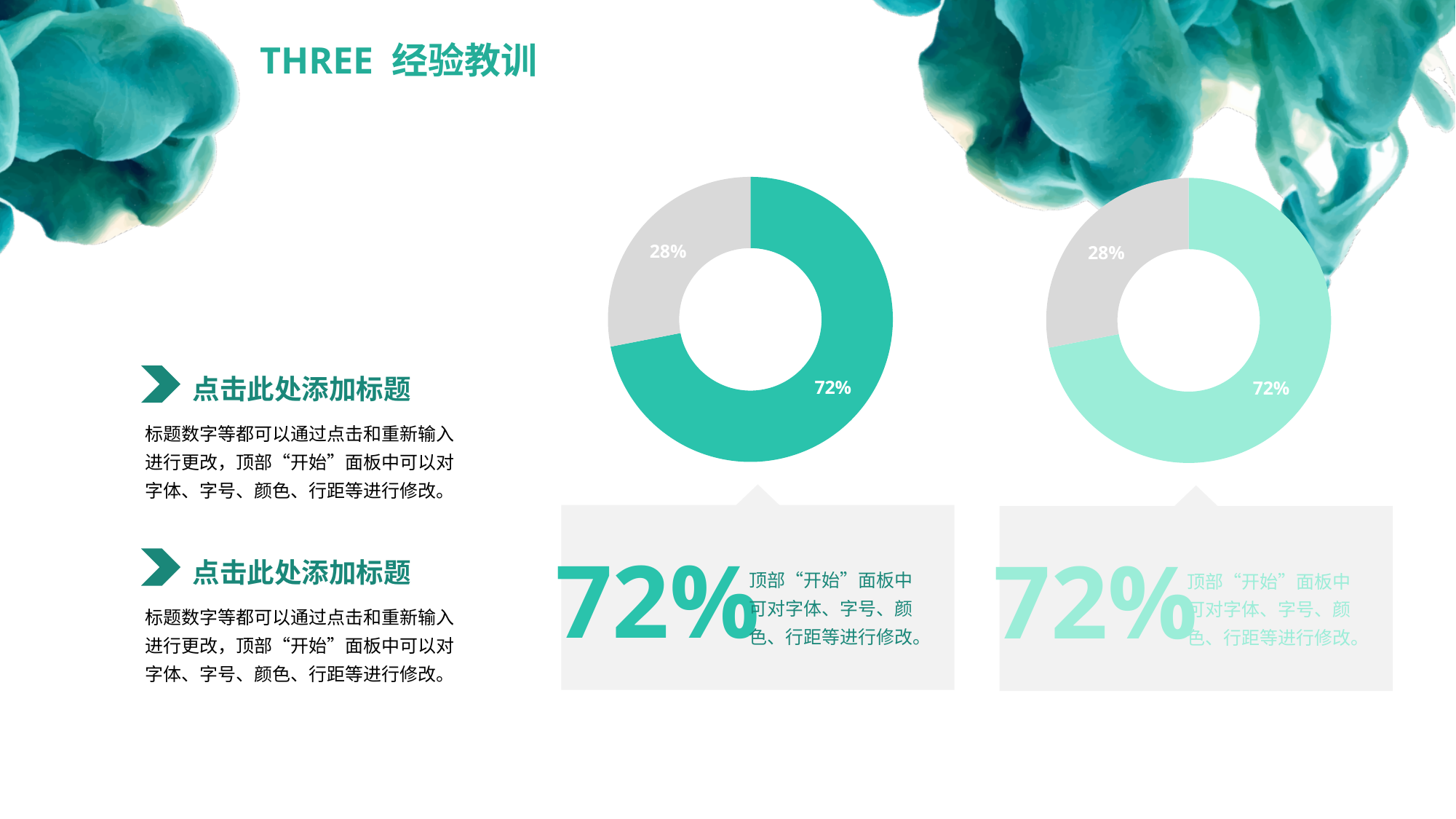
What kind of chart is the right chart on the slide? Doughnut chart What kind of chart is the left chart on the slide? Doughnut chart How many slices does the right doughnut chart have? 2 In the right doughnut chart, what value is shown on the grey slice? 28% In the left doughnut chart, what do the two slice values add up to? 100% In the left doughnut chart, what value is shown on the grey slice? 28% In the right doughnut chart, what value is shown on the light green slice? 72% In the left doughnut chart, what value is shown on the teal slice? 72% In the right doughnut chart, what is the difference between the two slice values? 44 percentage points How many slices does the left doughnut chart have? 2 In the left doughnut chart, which slice is larger, the teal one or the grey one? The teal one Do the left and right doughnut charts show the same values? Yes, 72% and 28%